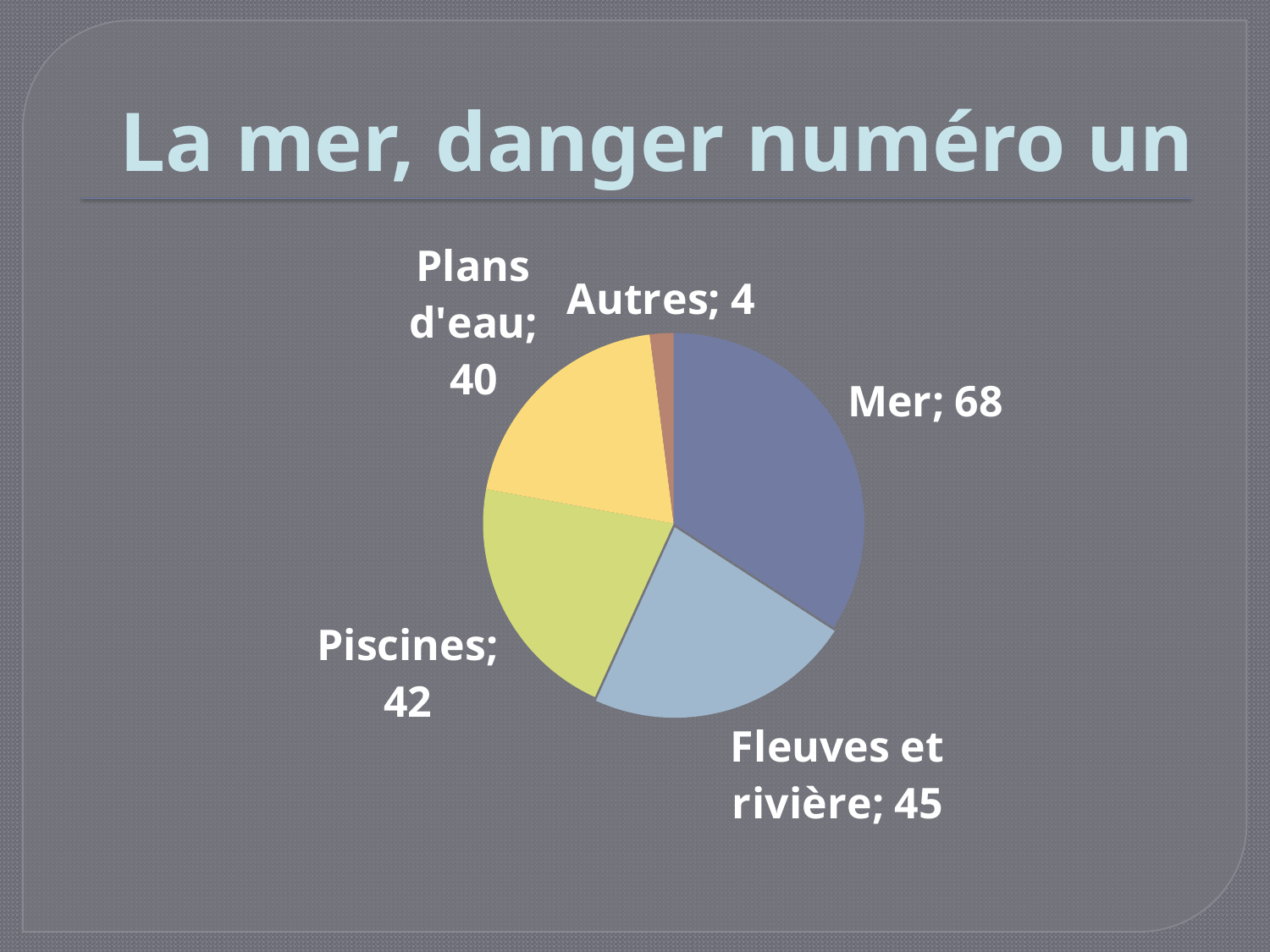
What is the value for Fleuves et rivière? 45 What is the value for Piscines? 42 What is the title of the slide? La mer, danger numéro un Which category has the smallest slice? Autres What kind of chart is shown on the slide? Pie chart What is the difference between the values for Mer and Fleuves et rivière? 23 Which is larger, the value for Piscines or the value for Plans d'eau? Piscines How many categories are shown in the pie chart? 5 What is the value for Plans d'eau? 40 What is the value for Autres? 4 What is the value for Mer? 68 Which category has the largest slice? Mer